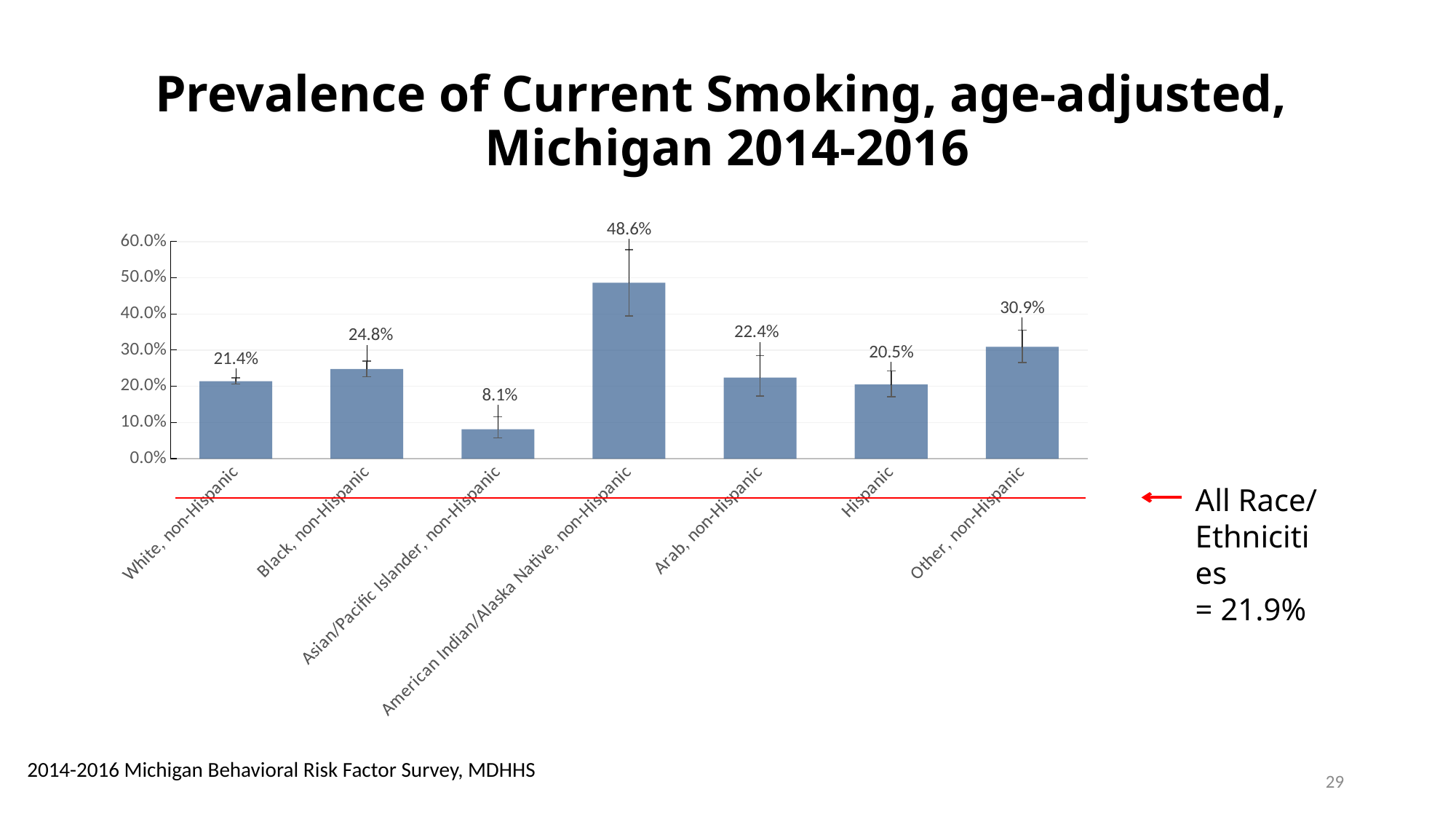
What is the difference in smoking prevalence between American Indian/Alaska Native, non-Hispanic and Other, non-Hispanic? 17.7% What is the prevalence of current smoking for White, non-Hispanic? 21.4% What is the difference in smoking prevalence between Black, non-Hispanic and White, non-Hispanic? 3.4% What is the prevalence of current smoking for American Indian/Alaska Native, non-Hispanic? 48.6% Is the value for Asian/Pacific Islander, non-Hispanic greater or less than 10.0%? less Which race/ethnicity group has the lowest prevalence of current smoking? Asian/Pacific Islander, non-Hispanic How many race/ethnicity categories are shown in the chart? 7 Which race/ethnicity group has the highest prevalence of current smoking? American Indian/Alaska Native, non-Hispanic What kind of chart is shown on the slide? Bar chart Which has a higher smoking prevalence, Arab, non-Hispanic or Hispanic? Arab, non-Hispanic What is the smoking prevalence for all race/ethnicities combined, as noted beside the chart? 21.9% What is the prevalence of current smoking for Other, non-Hispanic? 30.9%